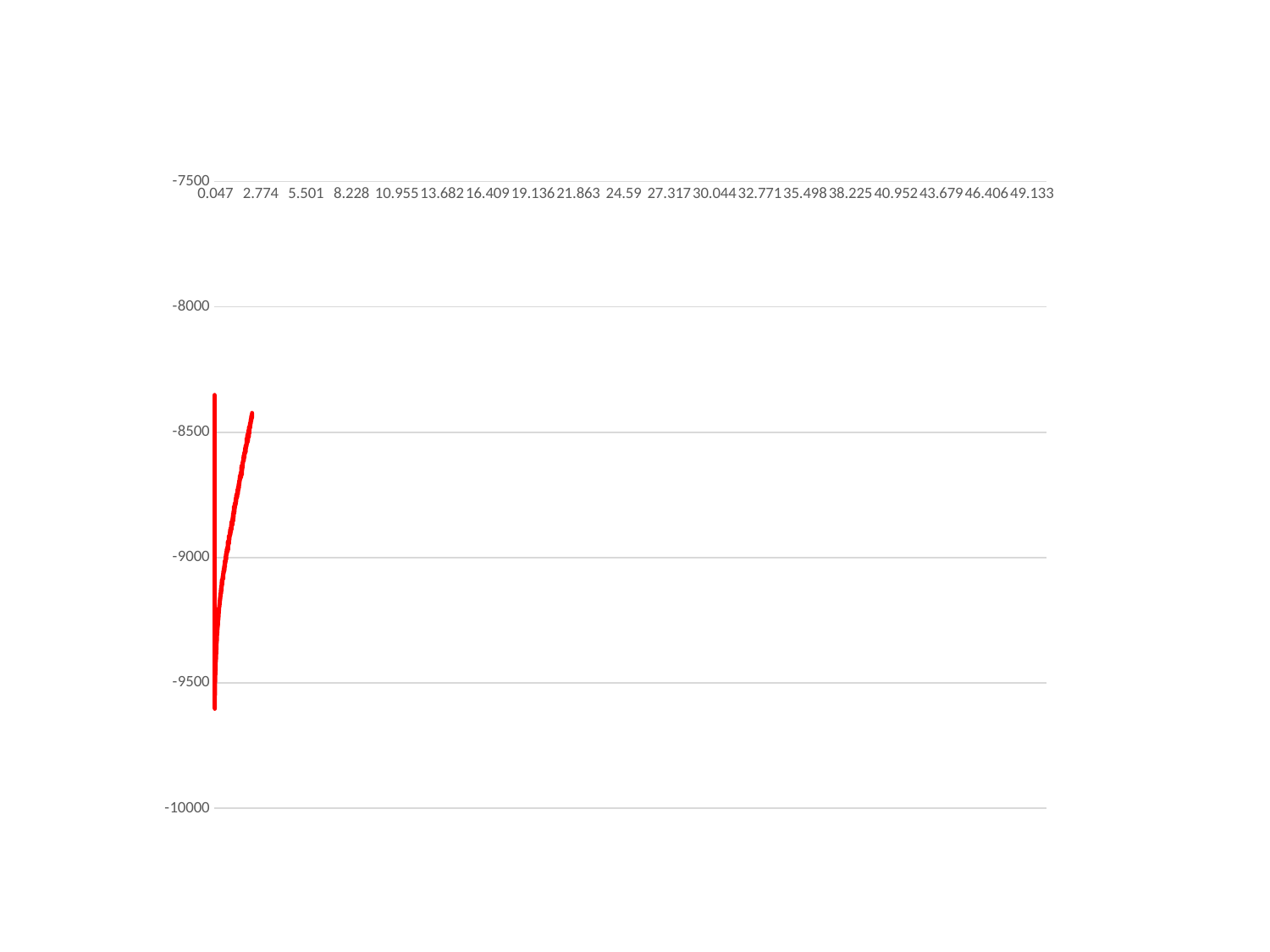
What is the first x-axis tick label? 0.047 What is the lowest value shown on the y axis? -10000 What colour is the plotted line? red How many tick labels are shown along the x axis? 19 Is the highest point of the plotted line greater or less than -8500? greater Is the highest point of the plotted line greater or less than -8000? less Is the lowest point of the plotted line greater or less than -9500? less What kind of chart is shown on the slide? line chart What is the highest value shown on the y axis? -7500